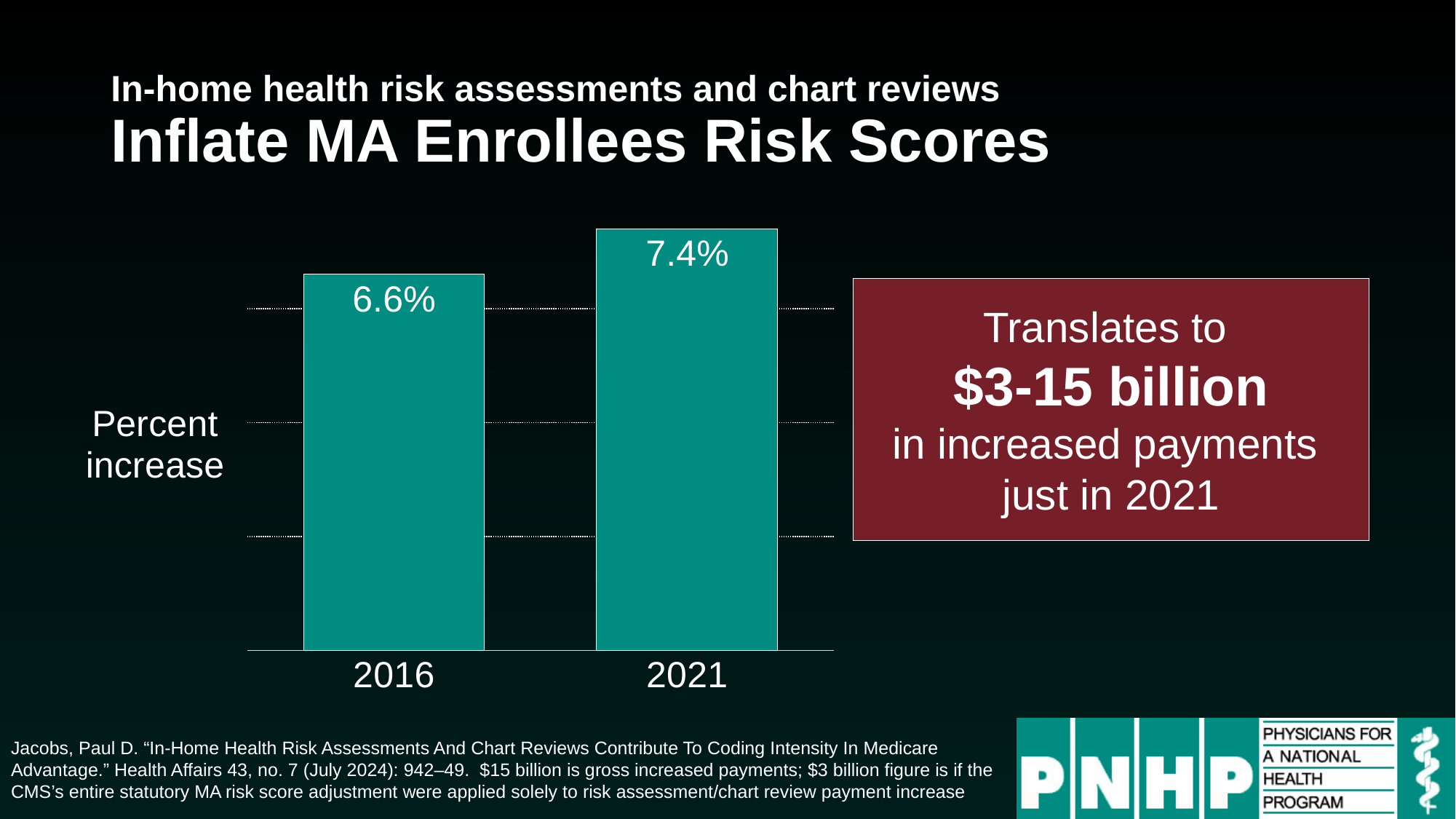
What kind of chart is shown on the slide? bar chart Which year has the lower percent increase? 2016 How many years are plotted in the chart? 2 What is the label on the vertical axis of the chart? Percent increase Is the value for 2021 larger or smaller than the value for 2016? larger Which year has the higher percent increase? 2021 What colour are the bars in the chart? teal What is the percent increase shown for 2021? 7.4% Do the values rise or fall from 2016 to 2021? rise What is the difference between the 2021 and 2016 percent increases? 0.8% What is the percent increase shown for 2016? 6.6%